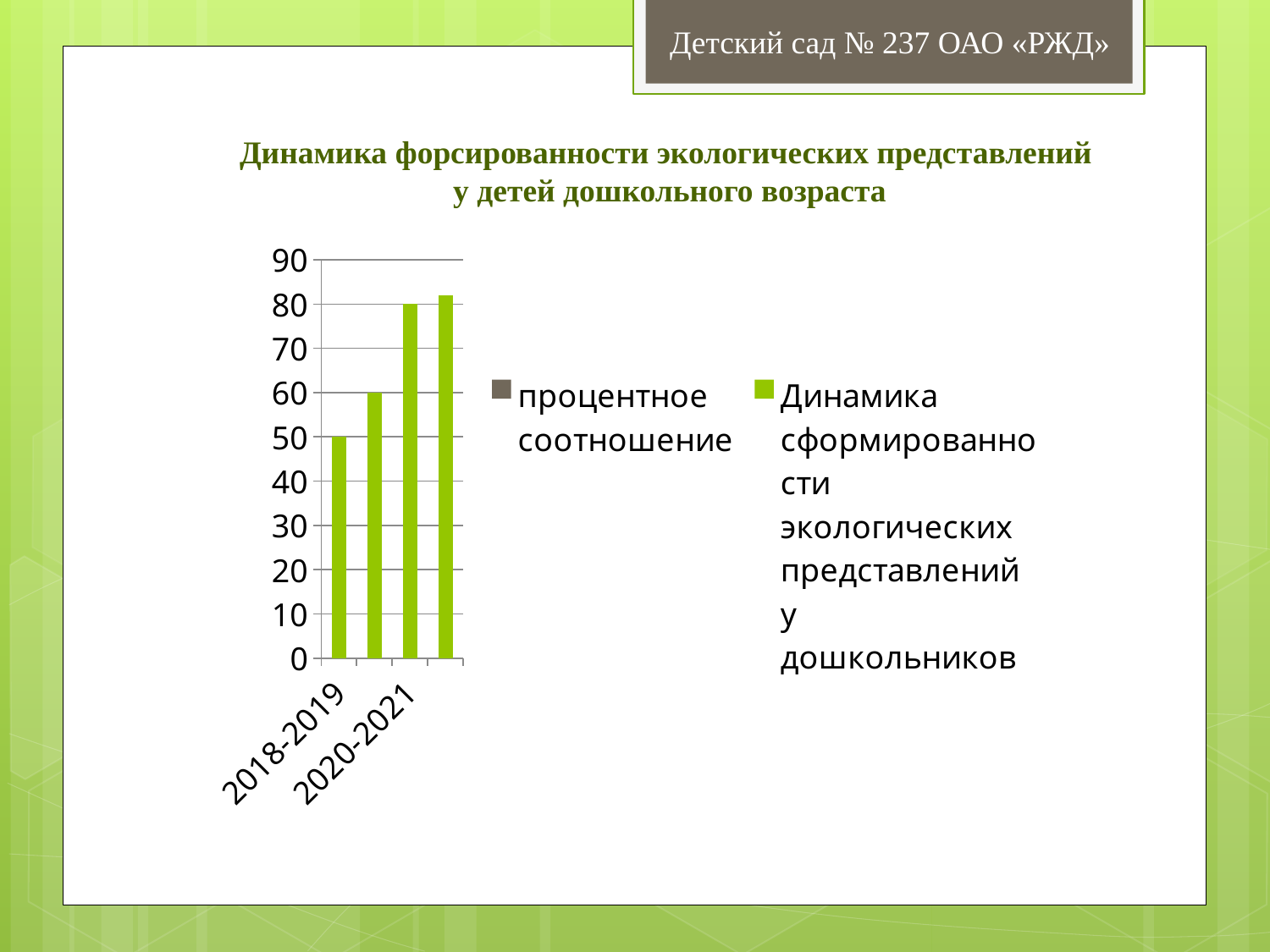
How many bars are plotted in the chart? 4 What value does the third bar from the left reach on the vertical axis? 80 Is the value of the leftmost bar greater or less than 60? less What kind of chart is shown on the slide? bar chart What value does the second bar from the left reach on the vertical axis? 60 What value does the leftmost bar reach on the vertical axis? 50 Which is larger, the leftmost bar or the third bar from the left? the third bar from the left Is the value of the rightmost bar greater or less than 70? greater Which bar is the lowest in the chart? the leftmost bar How many entries does the chart legend list? 2 Do the bar values rise or fall from left to right along the x axis? rise What is the difference between the third bar from the left and the leftmost bar? 30